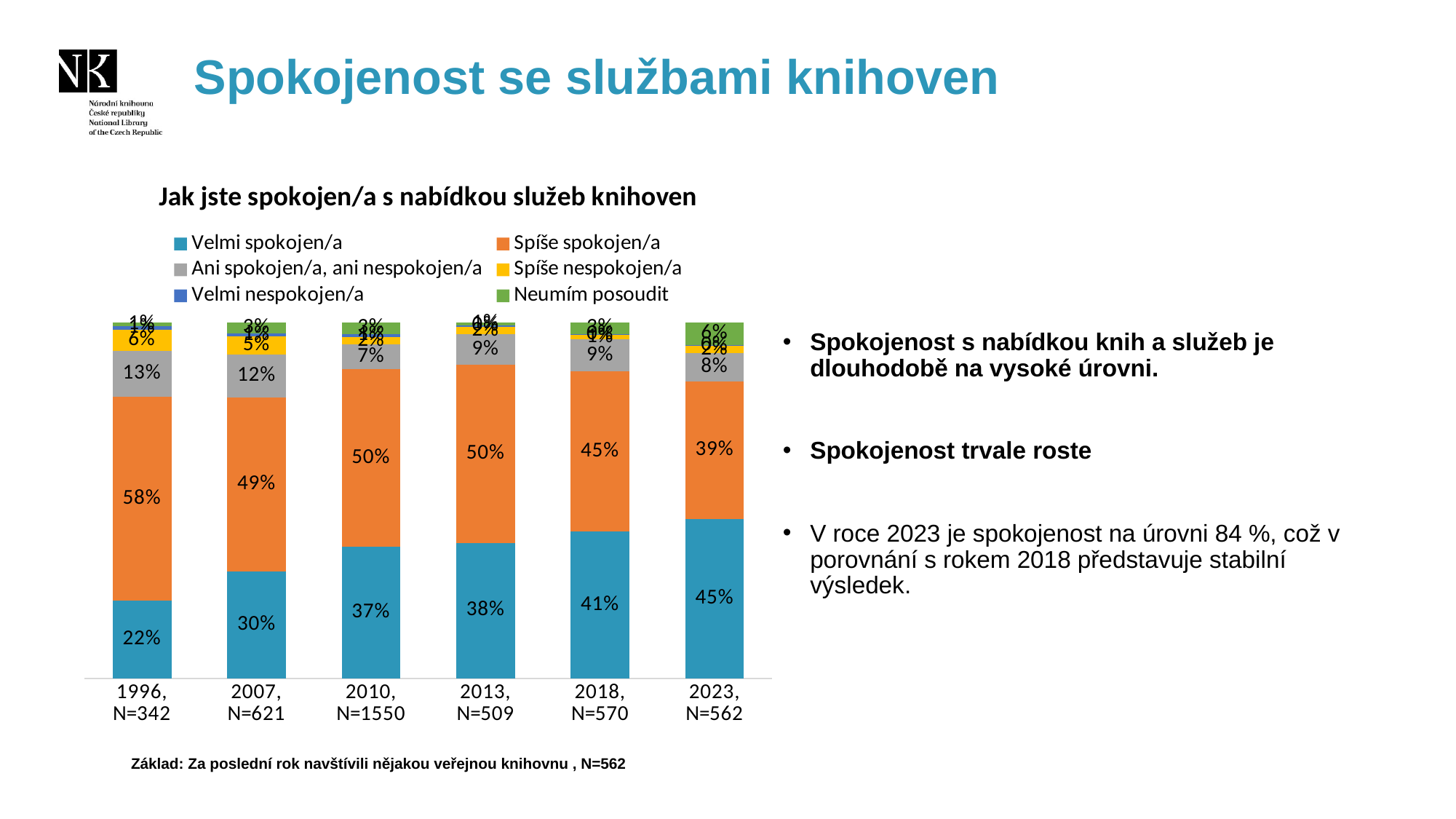
What is the value of 'Ani spokojen/a, ani nespokojen/a' for 2007, N=621? 12% Does the 'Velmi spokojen/a' share rise or fall from 1996 to 2023? Rise Which is larger in 2018, N=570: 'Velmi spokojen/a' or 'Spíše spokojen/a'? Spíše spokojen/a How many series does the legend list? 6 In which year is the 'Spíše spokojen/a' share the highest? 1996, N=342 What is the title of the chart? Jak jste spokojen/a s nabídkou služeb knihoven What kind of chart is shown on the slide? Stacked bar chart What is the difference between the 'Velmi spokojen/a' values for 2023 and 1996? 23 percentage points What is the value of 'Spíše spokojen/a' for 1996, N=342? 58% What is the value of 'Velmi spokojen/a' for 2023, N=562? 45% How many survey years (bars) are shown on the x axis? 6 In which year is the 'Velmi spokojen/a' share the lowest? 1996, N=342